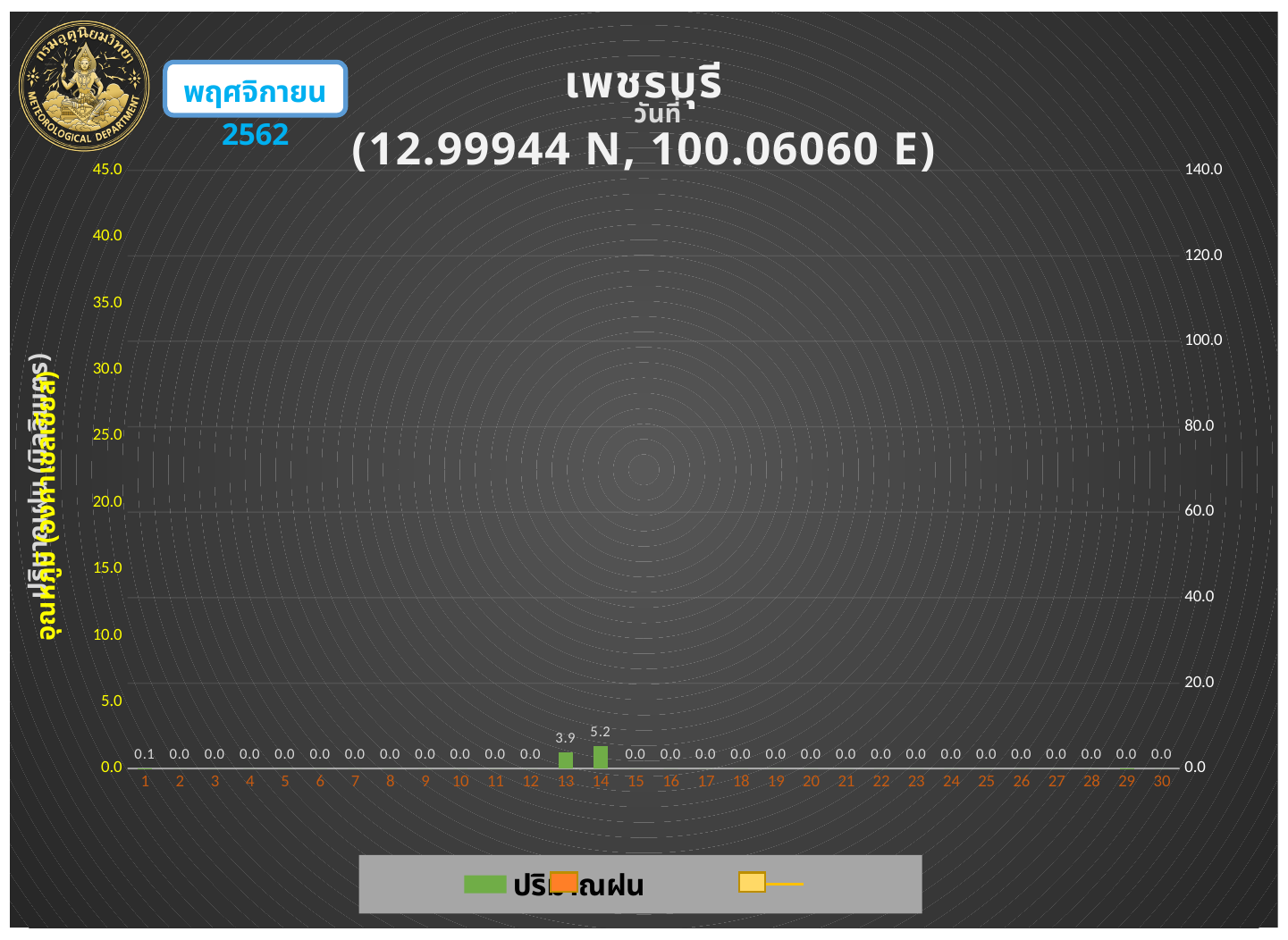
Which is larger, the value for day 13 or the value for day 14? day 14 How many days are shown on the x axis? 30 What is the highest tick value on the left vertical axis? 45.0 What is the value shown for day 13? 3.9 What is the value shown for day 20? 0.0 What is the highest tick value on the right vertical axis? 140.0 Which day has the highest value? 14 What is the value shown for day 1? 0.1 What is the value shown for day 14? 5.2 Is the value for day 14 greater or less than 10.0? less What is the difference between the values for day 14 and day 13? 1.3 What kind of chart is used to show the daily values? bar chart